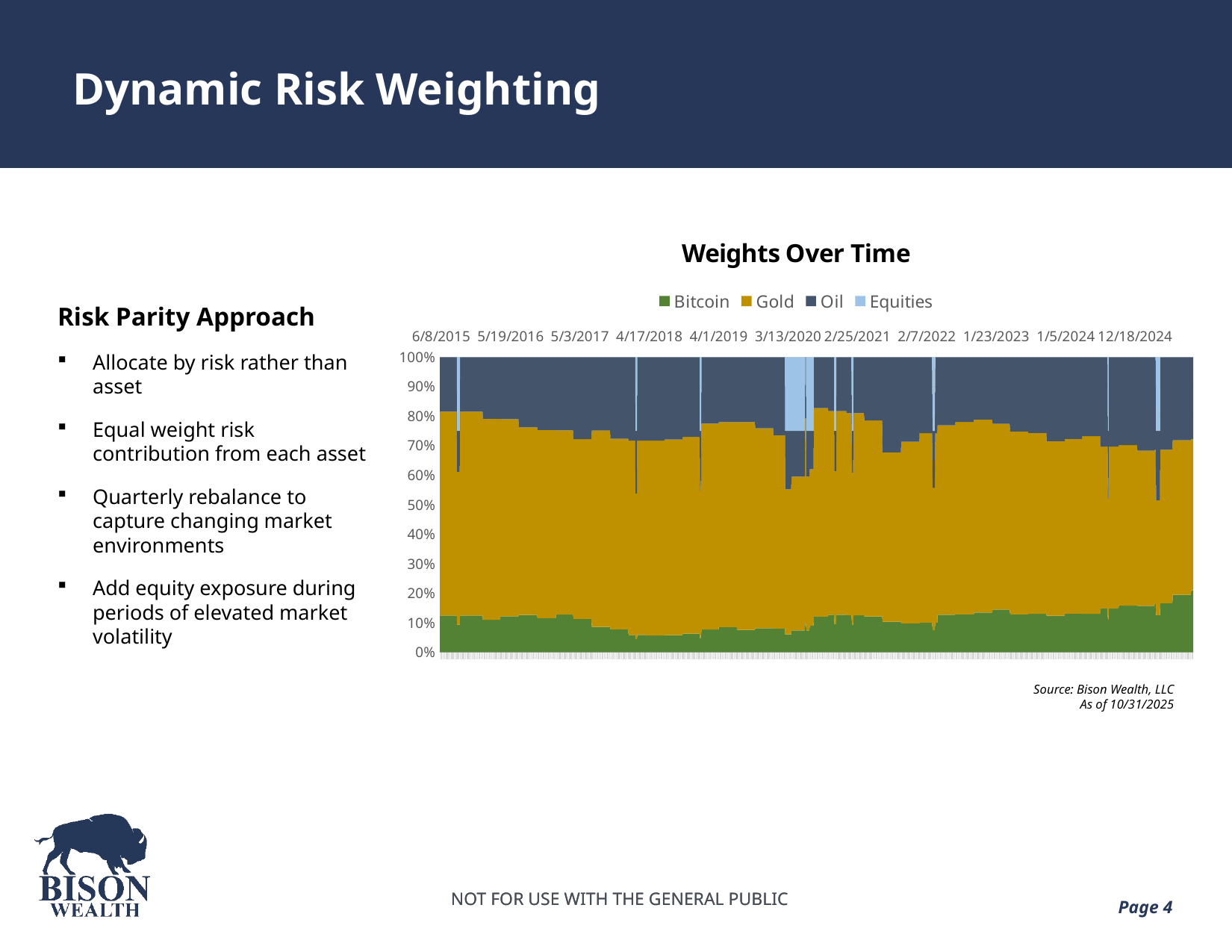
Which series in the "Weights Over Time" chart takes up the largest share of the stack across the period? Gold Which series is shown in green in the "Weights Over Time" chart? Bitcoin Is the Bitcoin weight at the start of the period (6/8/2015) greater or less than 20%? less Which series in the "Weights Over Time" chart takes up the smallest share of the stack across the period? Equities Does the Bitcoin weight at the end of the period appear higher or lower than at the start of the period? higher Is the combined weight of Bitcoin and Gold at the start of the period (6/8/2015) greater or less than 70%? greater Is the Bitcoin weight at the end of the period greater or less than 30%? less What is the highest value shown on the y axis of the chart? 100% How many date labels are shown along the x axis of the chart? 11 How many series does the legend of the "Weights Over Time" chart list? 4 What is the title of the chart on the slide? Weights Over Time What kind of chart is shown on the slide? Stacked area chart